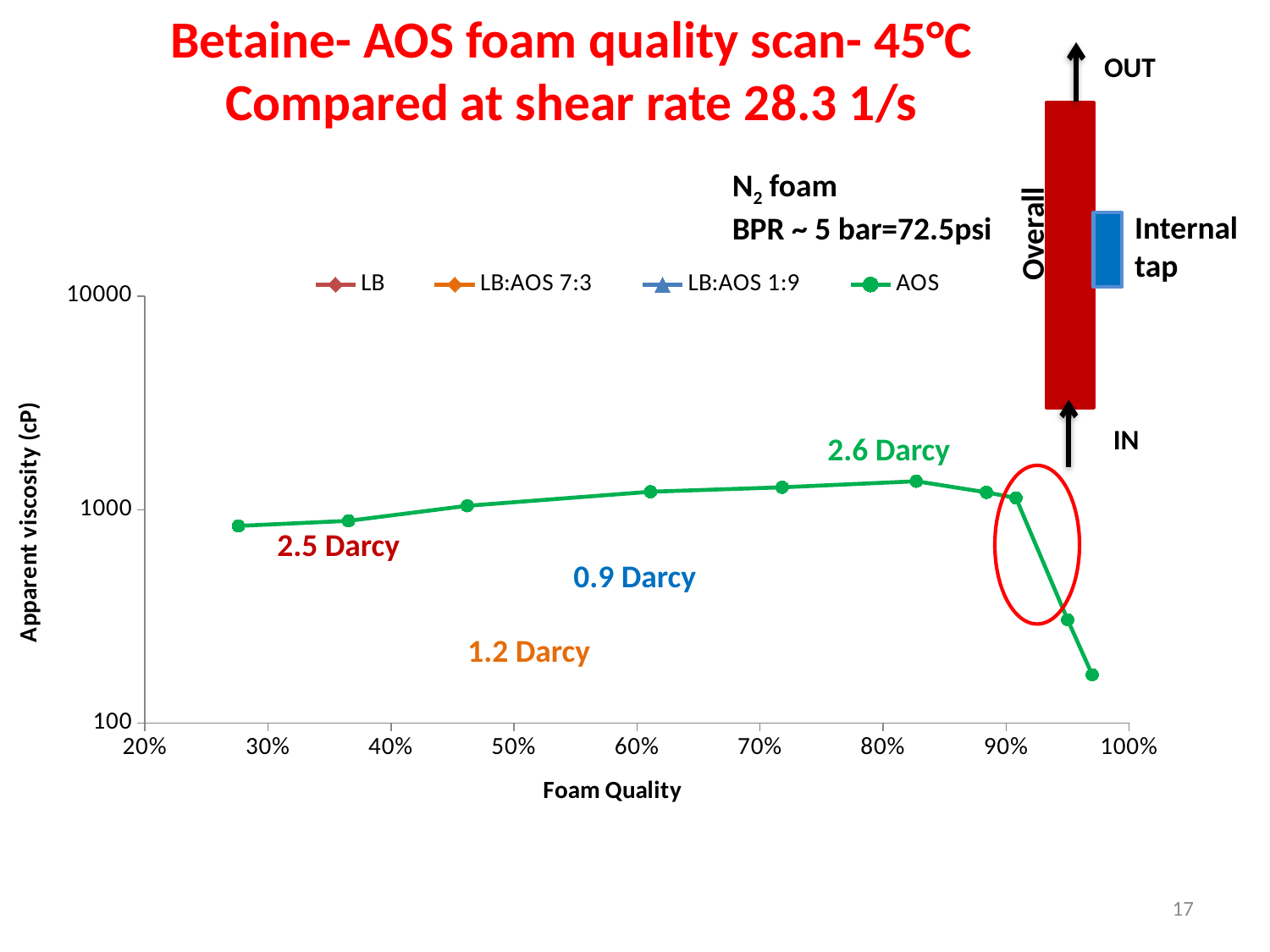
What is the title of the y axis of the chart? Apparent viscosity (cP) What is the title of the x axis of the chart? Foam Quality How many data points are plotted on the AOS series? 10 Is the apparent viscosity of the AOS point near 83% foam quality greater or less than 1000? greater Is the apparent viscosity of the leftmost AOS point (near 28% foam quality) greater or less than 1000? less Does the AOS apparent viscosity rise or fall as foam quality increases from 90% to 100%? fall Is the apparent viscosity of the rightmost AOS point (near 97% foam quality) greater or less than 1000? less Does the AOS apparent viscosity rise or fall as foam quality increases from 30% to 80%? rise Which end of the AOS series, left or right, has the lowest apparent viscosity? right How many series does the chart legend list? 4 What kind of chart is shown on the slide? line chart Which is larger for the AOS series: the apparent viscosity at about 61% foam quality or at about 95% foam quality? 61%